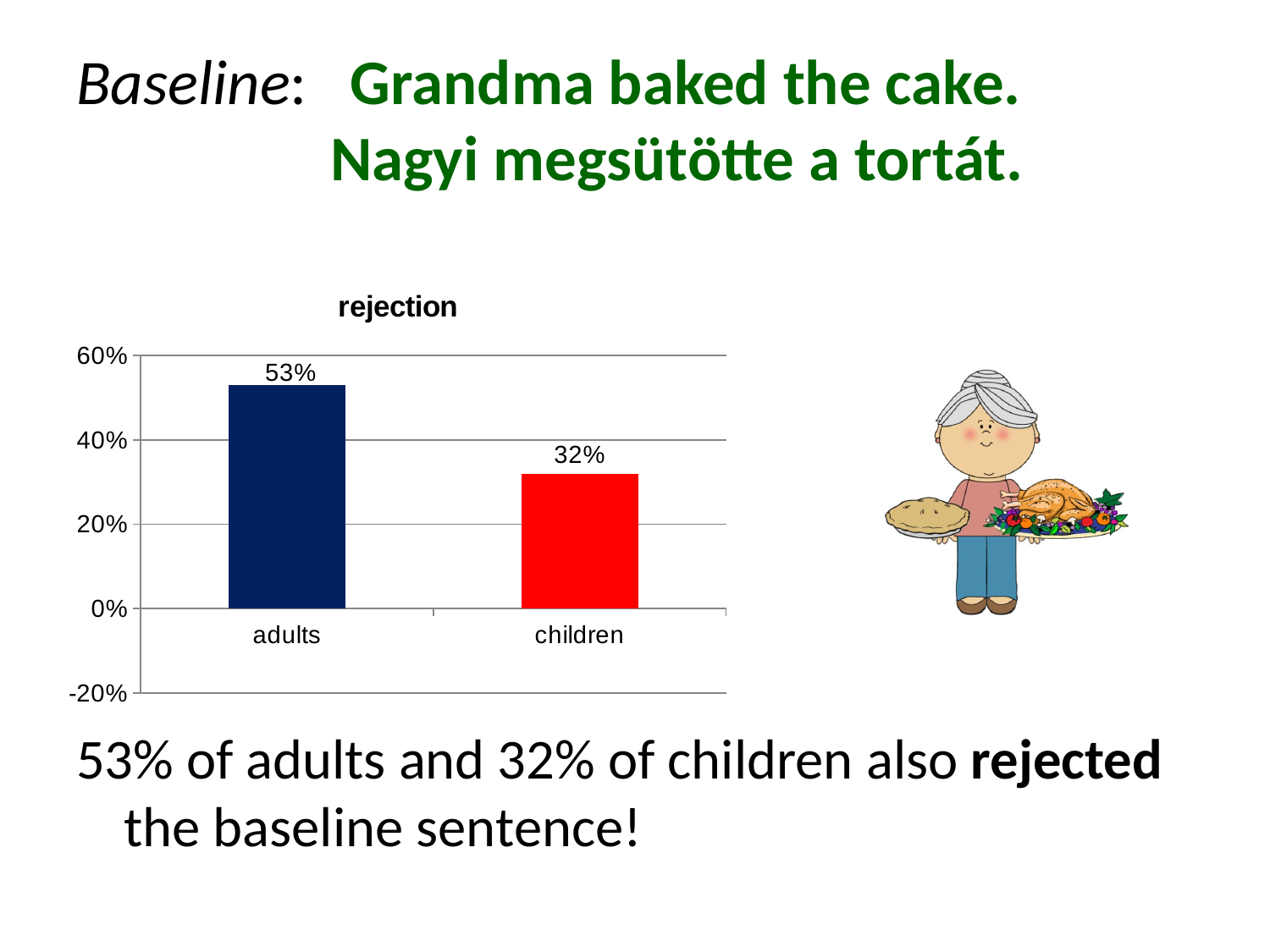
What is the rejection value for children? 32% Is the rejection value for adults greater or less than 40%? greater What is the title of the chart? rejection What is the rejection value for adults? 53% What kind of chart is shown on the slide? bar chart What colour is the bar for children? red What is the difference between the rejection values for adults and children? 21% How many categories are shown in the chart? 2 Which category has the lowest rejection value? children Is the rejection value for children greater or less than 40%? less Which is larger, the rejection value for adults or for children? adults Which category has the highest rejection value? adults